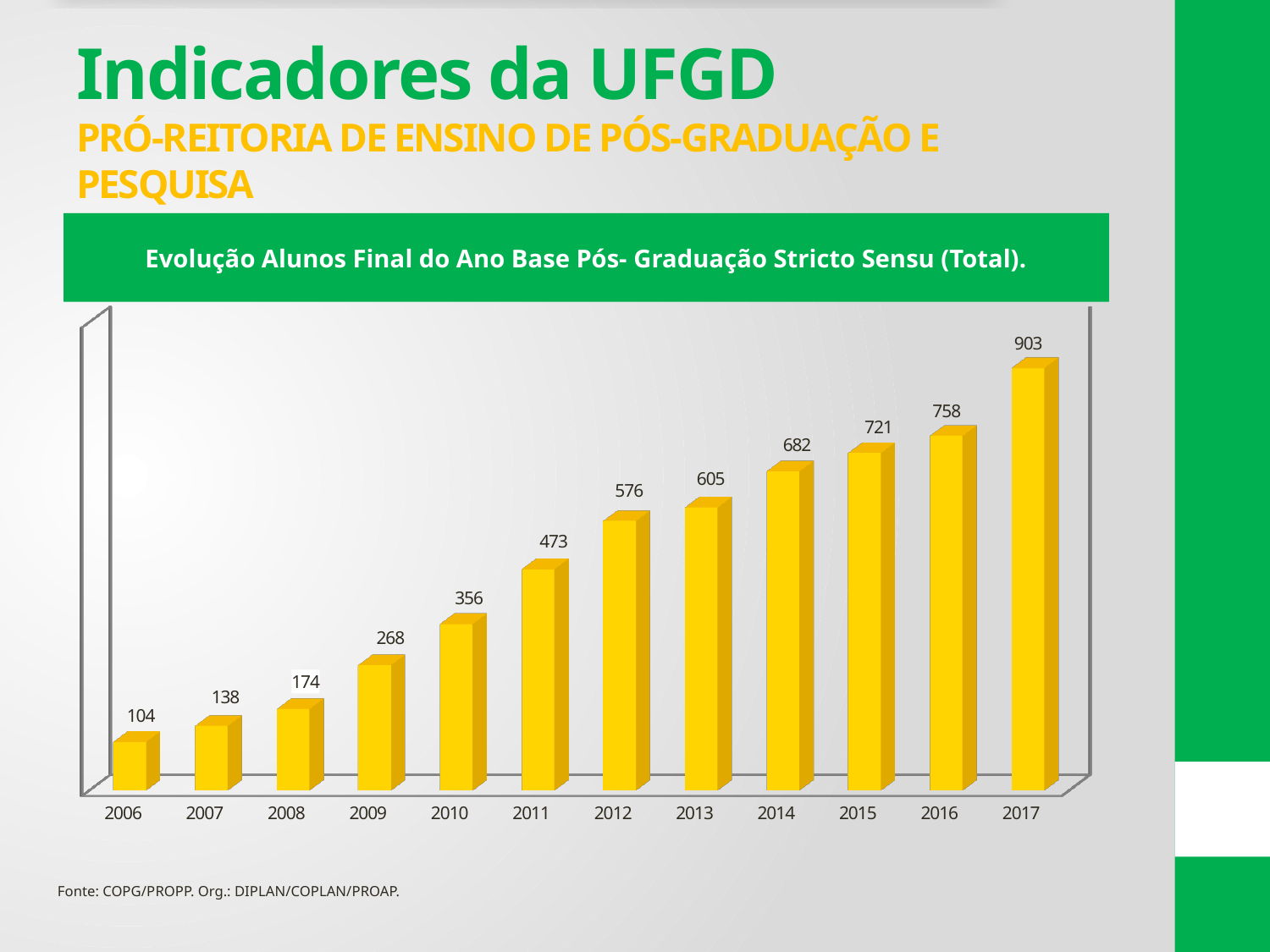
Which is larger, the value for 2009 or the value for 2013? 2013 Which year has the lowest value? 2006 What is the value for 2006? 104 What is the value for 2014? 682 How many years are shown on the x axis? 12 Do the values rise or fall from 2006 to 2017? rise What kind of chart is shown? bar chart What is the value for 2010? 356 What is the difference between the values for 2012 and 2011? 103 What is the title of the chart? Evolução Alunos Final do Ano Base Pós- Graduação Stricto Sensu (Total). Which year has the highest value? 2017 What is the difference between the values for 2017 and 2016? 145